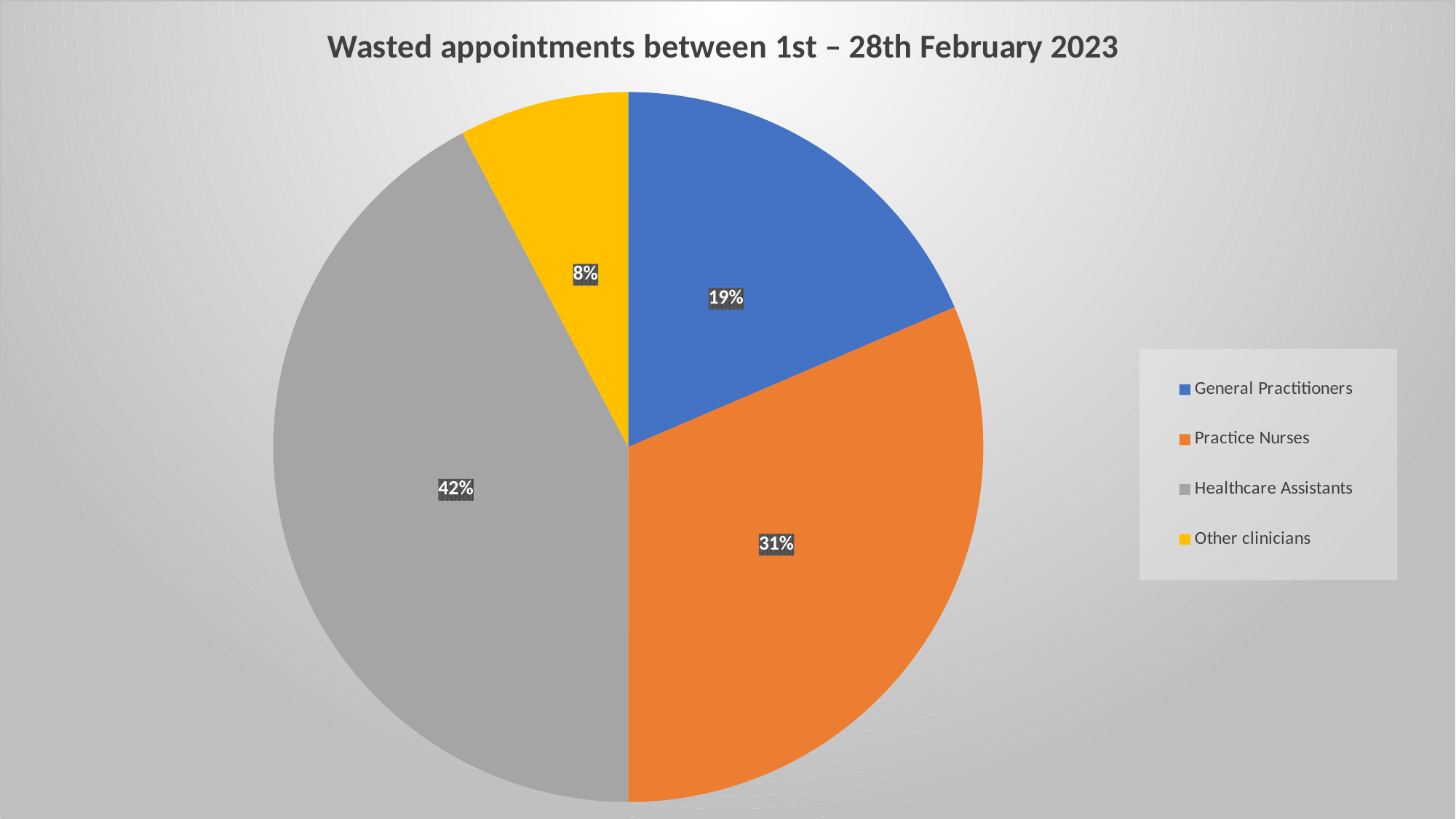
What share of wasted appointments is attributed to General Practitioners? 19% How many categories does the pie chart show? 4 What share of wasted appointments is attributed to Other clinicians? 8% What kind of chart is shown on the slide? Pie chart What share of wasted appointments is attributed to Healthcare Assistants? 42% What colour represents Other clinicians in the chart? Yellow Which category has the smallest share of wasted appointments? Other clinicians What is the title of the chart? Wasted appointments between 1st – 28th February 2023 Which category has the largest share of wasted appointments? Healthcare Assistants What is the difference in percentage points between Healthcare Assistants and Practice Nurses? 11 Which has a larger share, General Practitioners or Practice Nurses? Practice Nurses